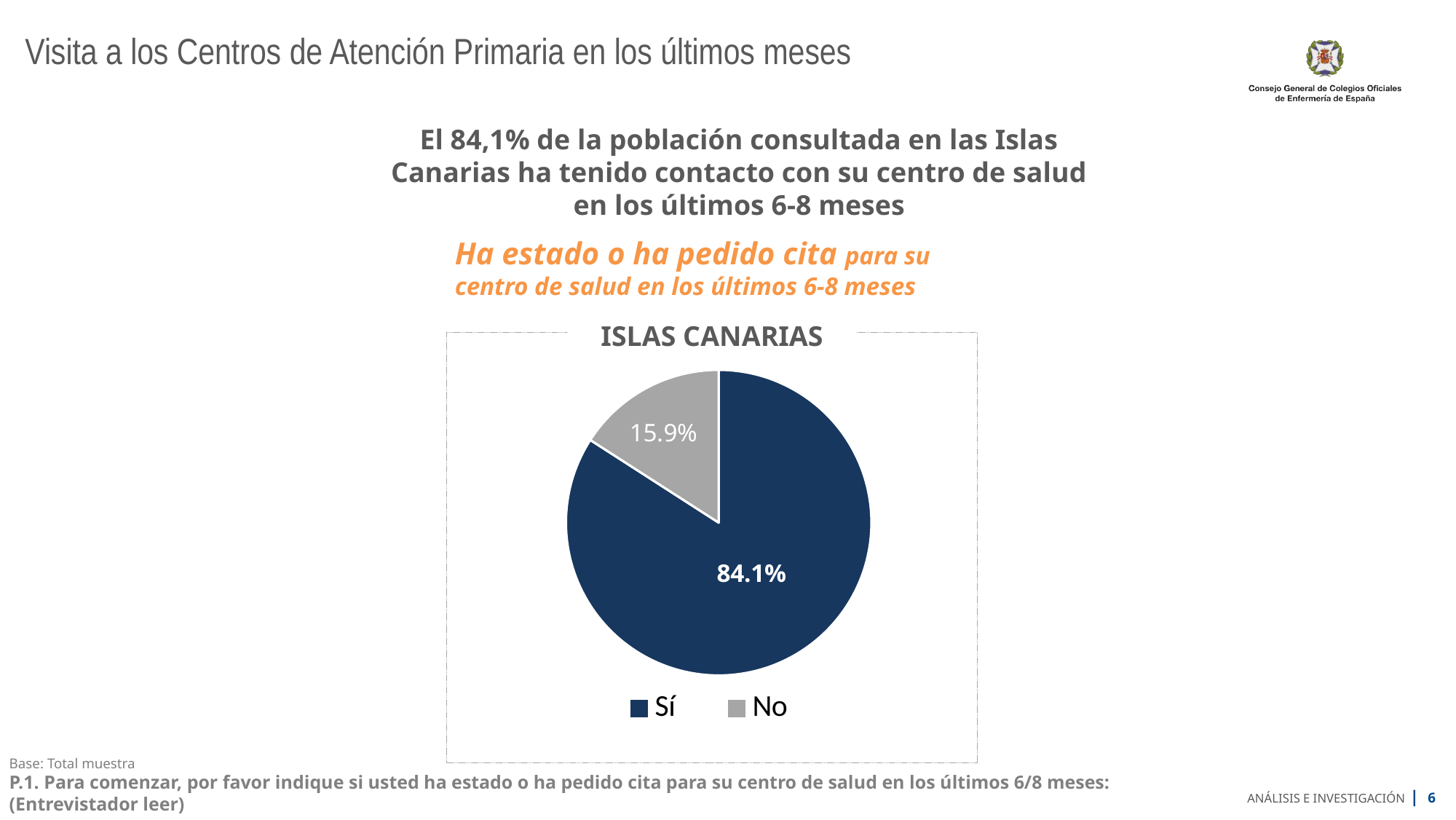
What kind of chart is shown on the slide? Pie chart What colour is the "No" slice in the pie chart? Grey How many entries does the legend list? 2 How many slices does the pie chart have? 2 Which is larger, the "Sí" slice or the "No" slice? Sí What is the combined total of the two slices in the pie chart? 100% What percentage of the pie chart corresponds to "No"? 15.9% What is the title of the chart? ISLAS CANARIAS Which category has the smallest slice in the pie chart? No What percentage of the pie chart corresponds to "Sí"? 84.1% What is the difference in percentage points between the "Sí" and "No" slices? 68.2 Which category has the largest slice in the pie chart? Sí